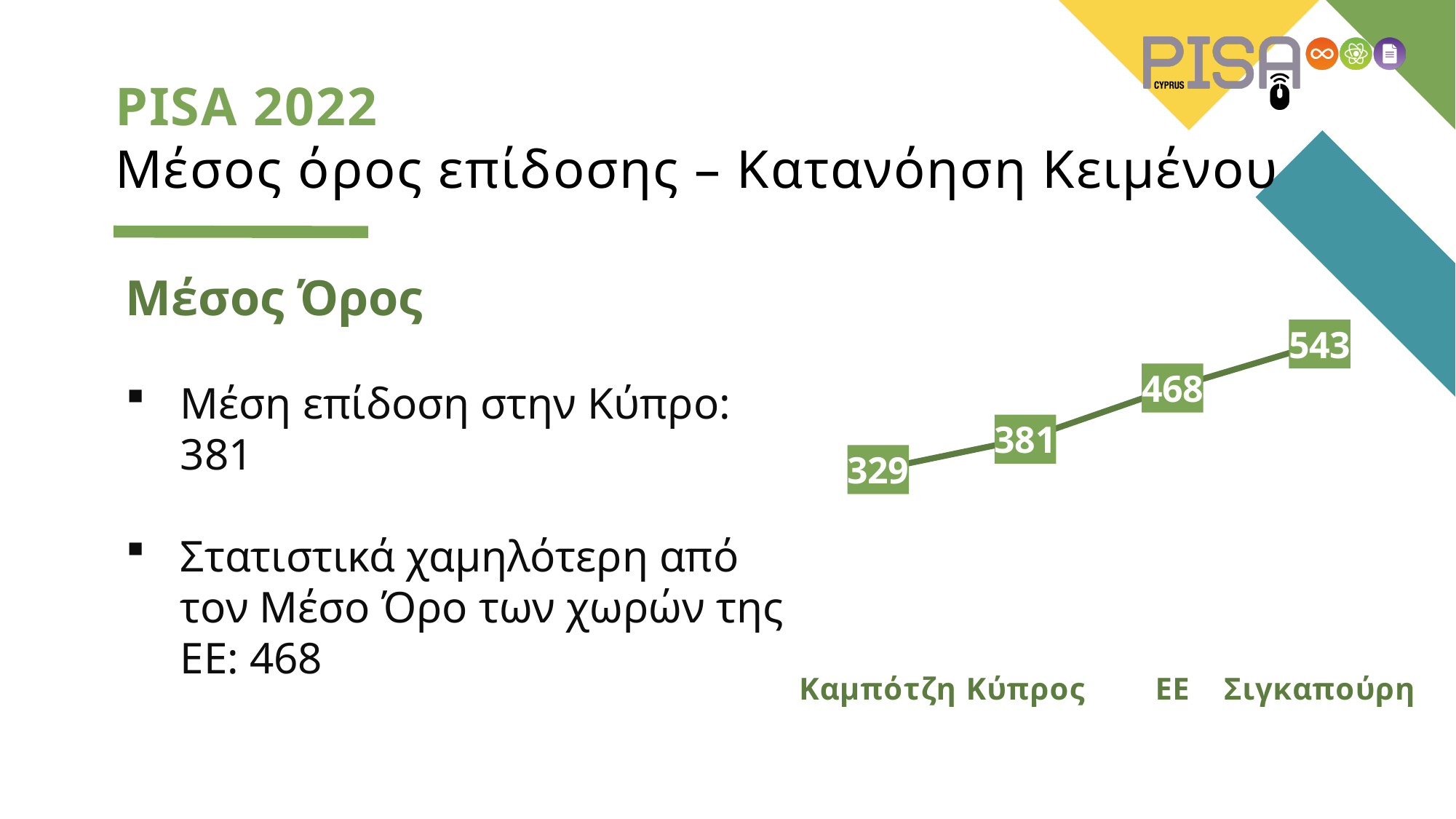
What is the value for Κύπρος in the chart? 381 What is the value for ΕΕ in the chart? 468 What is the value for Καμπότζη in the chart? 329 Do the values rise or fall from left to right along the x axis? rise How many categories are plotted in the chart? 4 What is the difference between the values for ΕΕ and Κύπρος? 87 Which category has the lowest value in the chart? Καμπότζη What is the value for Σιγκαπούρη in the chart? 543 What is the difference between the values for Σιγκαπούρη and Καμπότζη? 214 What kind of chart is shown on the slide? line chart Which category has the highest value in the chart? Σιγκαπούρη Which has a larger value, Κύπρος or ΕΕ? ΕΕ